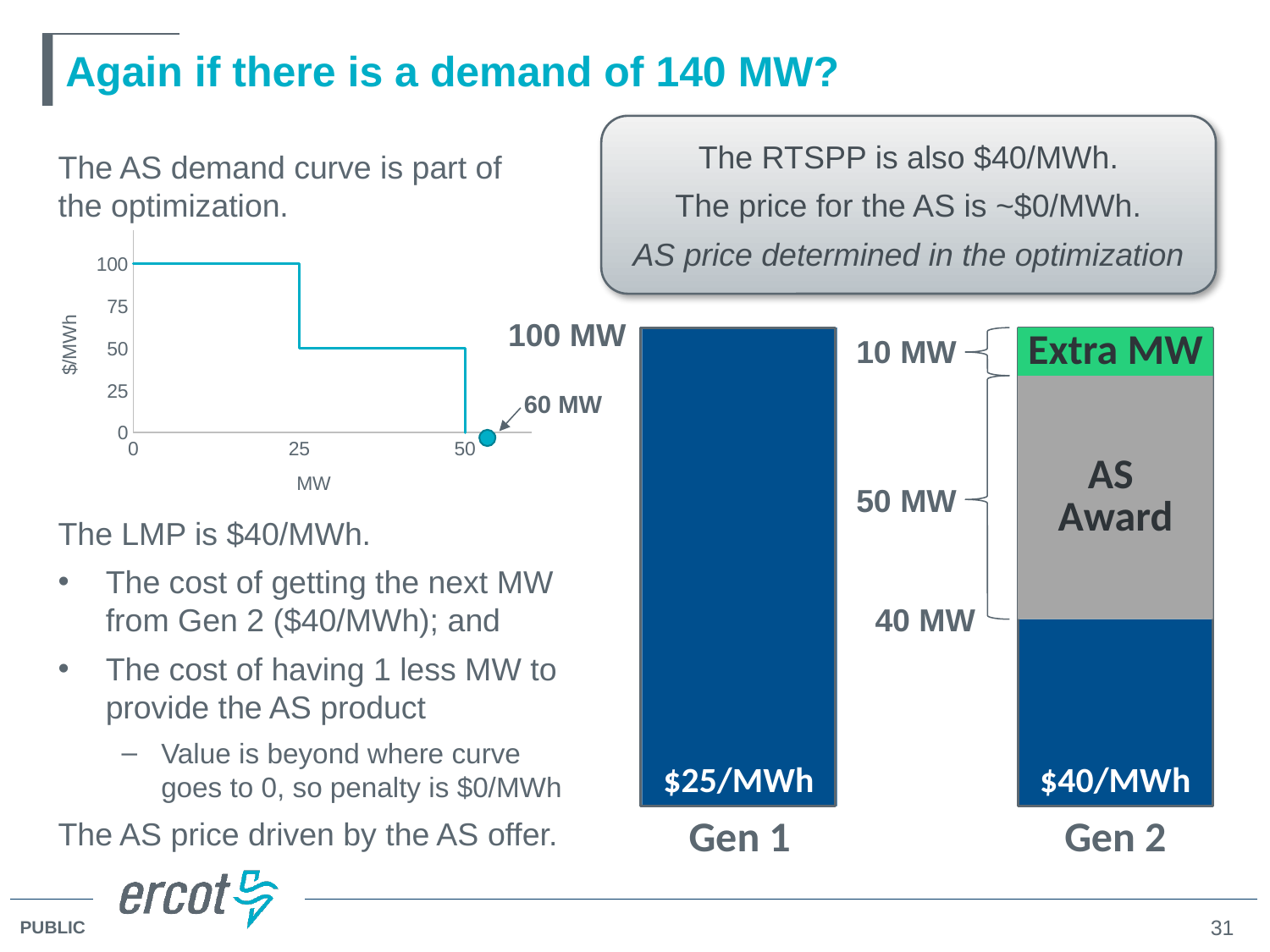
In the bar chart on the right, how many MW is the Extra MW segment of the Gen 2 bar? 10 MW In the bar chart on the right, what is the difference between the Gen 2 price and the Gen 1 price? $15/MWh In the bar chart on the right, how many generators are shown? 2 In the AS demand curve chart on the left, what is the $/MWh value of the curve between 0 and 25 MW? 100 In the bar chart on the right, what is the price label shown on the Gen 2 bar? $40/MWh In the AS demand curve chart on the left, does the value rise or fall as MW increases? Fall In the bar chart on the right, what is the price label shown on the Gen 1 bar? $25/MWh In the bar chart on the right, which generator has the higher price per MWh, Gen 1 or Gen 2? Gen 2 In the bar chart on the right, what colour is the Extra MW segment? Green In the bar chart on the right, how many MW does the Gen 1 bar represent? 100 MW In the bar chart on the right, how many MW is the AS Award segment of the Gen 2 bar? 50 MW In the bar chart on the right, what is the total MW of the Gen 2 bar (40 MW + 50 MW + 10 MW)? 100 MW